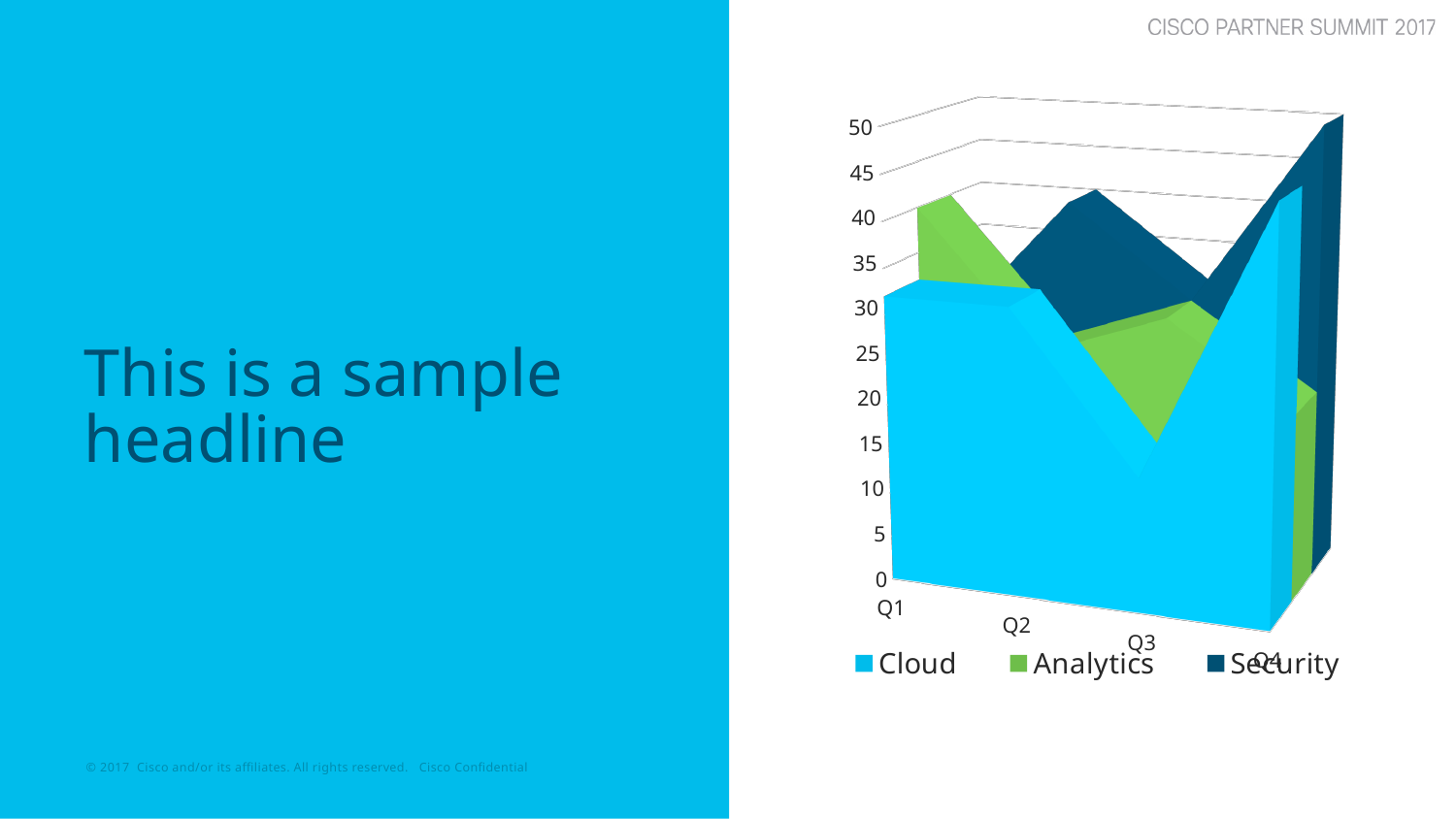
What are the categories on the x axis of the chart? Q1, Q2, Q3, Q4 Is the Analytics value for Q1 larger or smaller than the Analytics value for Q3? larger In which quarter is the Cloud series at its highest? Q4 How many series does the chart's legend list? 3 What kind of chart is shown on the slide? Area chart Is the Analytics value for Q3 greater or less than 25? greater In which quarter is the Analytics series at its lowest? Q4 How many categories are shown on the x axis of the chart? 4 Does the Cloud series rise or fall from Q3 to Q4? rise Which series are listed in the chart's legend? Cloud, Analytics, Security In which quarter is the Analytics series at its highest? Q1 Does the Analytics series rise or fall from Q1 to Q3? fall